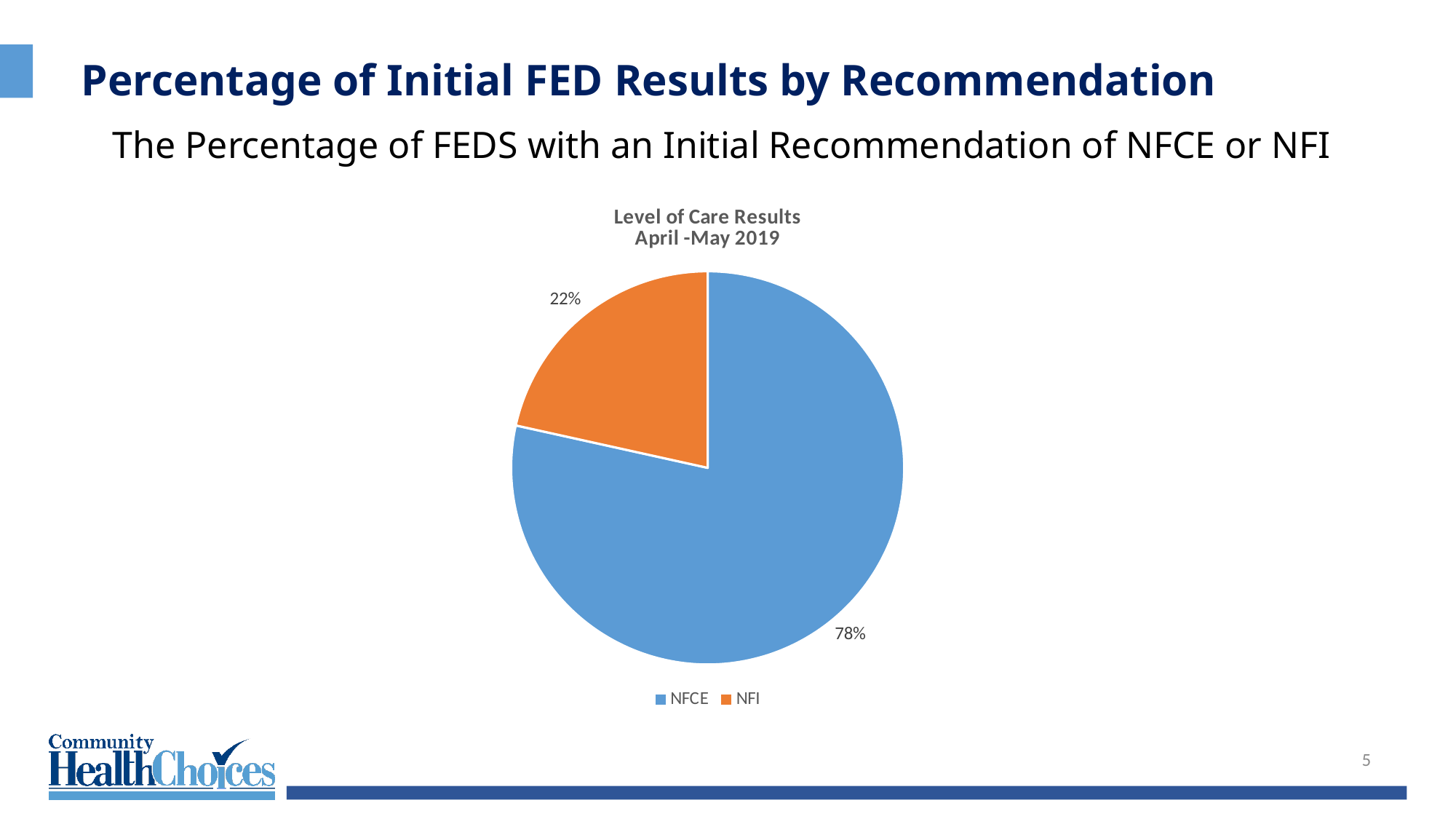
How many entries does the legend list? 2 What is the title of the chart? Level of Care Results April -May 2019 What share of the pie does the NFI slice represent? 22% How many slices does the pie chart have? 2 What percentage of the pie is NFI? 22% Which category has the largest share of the pie? NFCE Which category has the smallest share of the pie? NFI What percentage of the pie is NFCE? 78% What colour is the NFI slice? Orange Which is larger, the NFCE slice or the NFI slice? NFCE What kind of chart is shown on the slide? Pie chart What is the difference in percentage points between the NFCE and NFI slices? 56